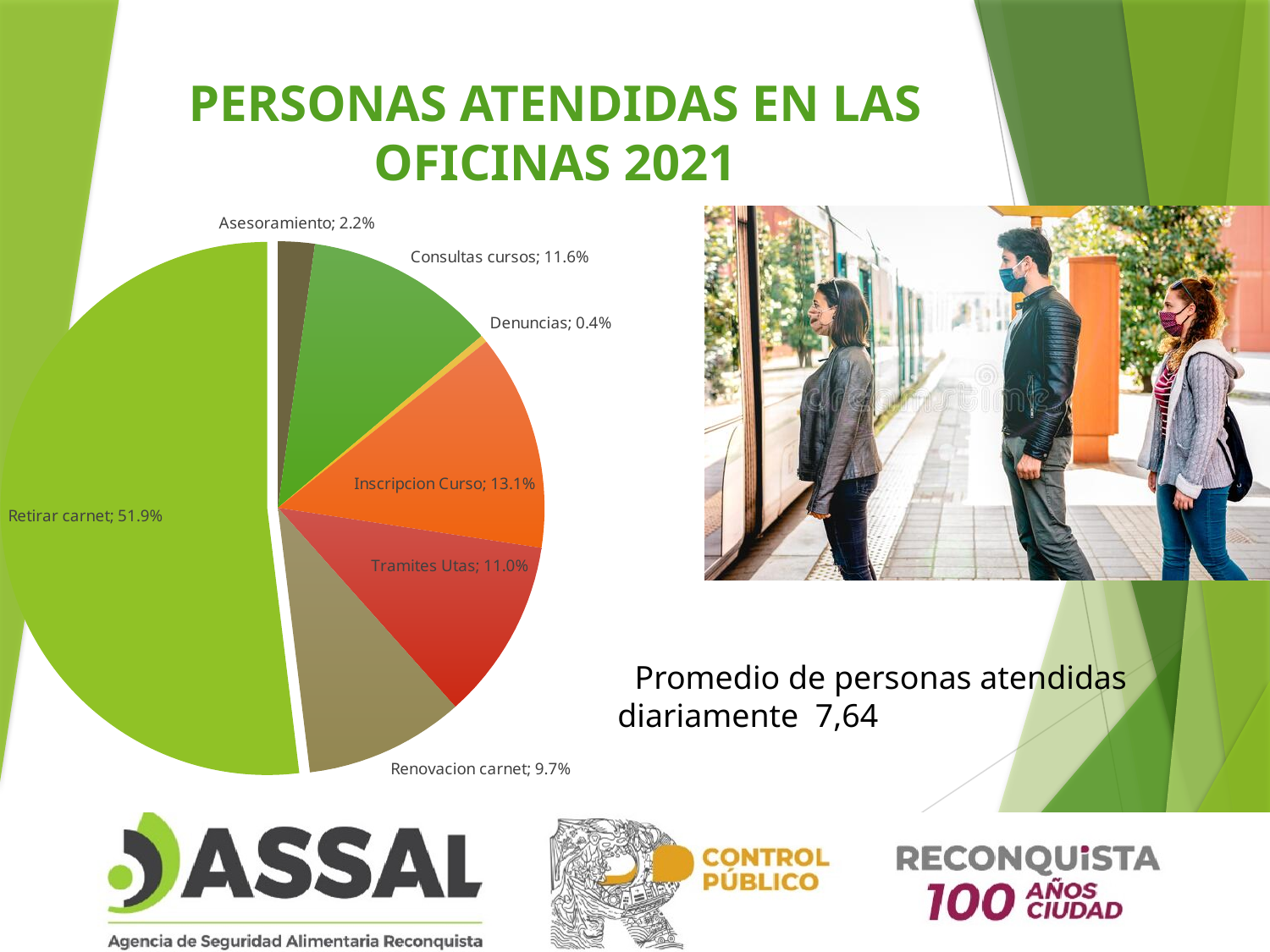
Which is larger, the share for Inscripcion Curso or the share for Tramites Utas? Inscripcion Curso What is the difference in percentage points between Retirar carnet and Inscripcion Curso? 38.8 What percentage is shown for Denuncias? 0.4% What percentage of people attended is shown for Retirar carnet? 51.9% What percentage is shown for Renovacion carnet? 9.7% What kind of chart is shown on the slide? Pie chart What is the title of the slide containing the pie chart? PERSONAS ATENDIDAS EN LAS OFICINAS 2021 What percentage is shown for Inscripcion Curso? 13.1% How many categories (slices) does the pie chart have? 7 Which category has the largest share of the pie? Retirar carnet Which category has the smallest share of the pie? Denuncias What percentage is shown for Consultas cursos? 11.6%